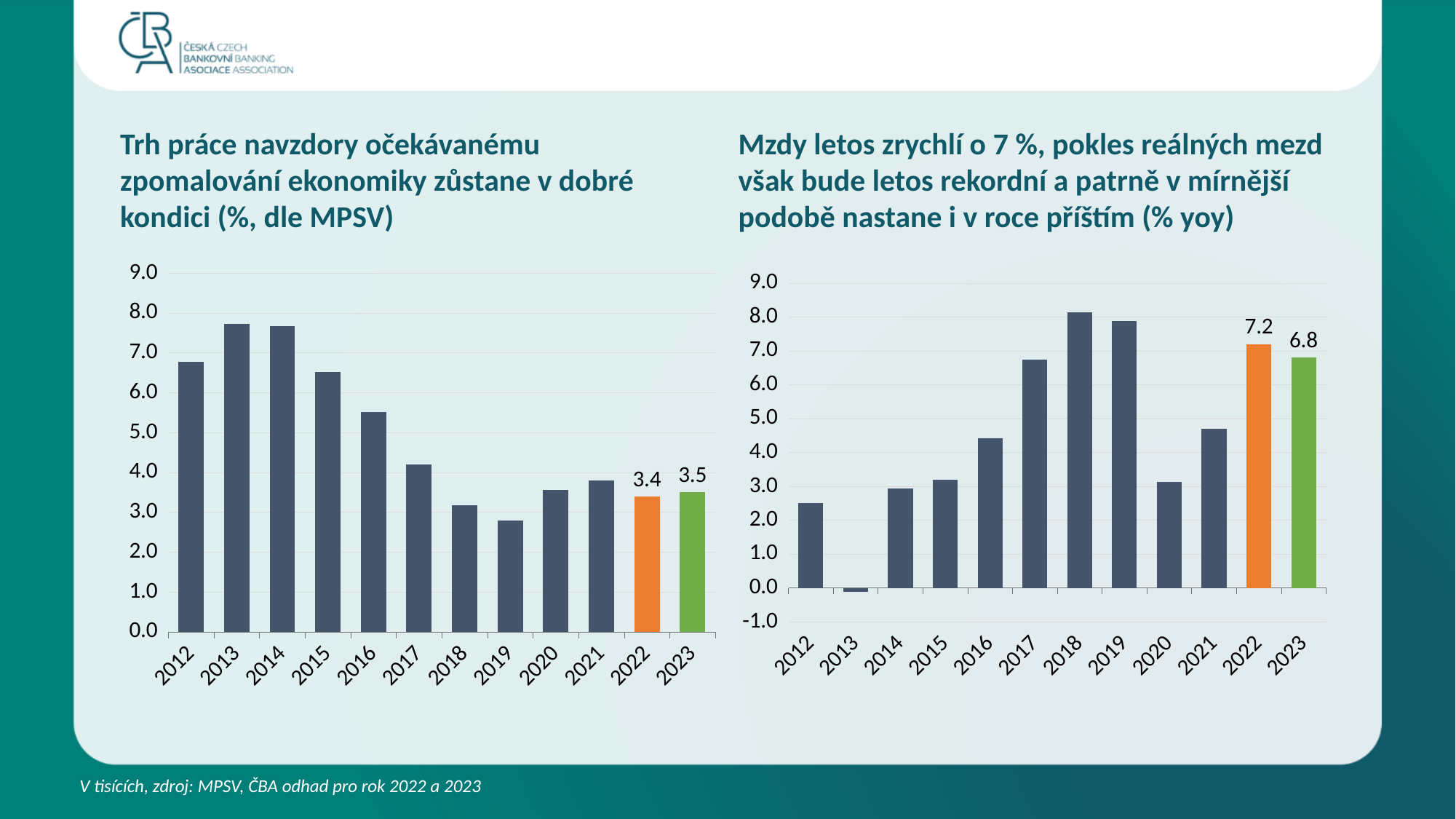
In the right chart (Mzdy letos zrychlí...), what is the value for 2022? 7.2 In the right chart (Mzdy letos zrychlí...), what is the value for 2023? 6.8 In the right chart (Mzdy letos zrychlí...), which year has the lowest value? 2013 In the left chart (Trh práce...), what is the value for 2023? 3.5 In the left chart (Trh práce...), what is the value for 2022? 3.4 In the left chart (Trh práce...), which is larger, the value for 2017 or the value for 2018? 2017 In the left chart (Trh práce...), is the value for 2016 greater or less than 5.0? greater In the left chart (Trh práce...), which year has the lowest value? 2019 What type of chart is the left chart (Trh práce...)? bar chart How many years are shown on the x axis of the right chart (Mzdy letos zrychlí...)? 12 In the right chart (Mzdy letos zrychlí...), what is the difference between the values for 2022 and 2023? 0.4